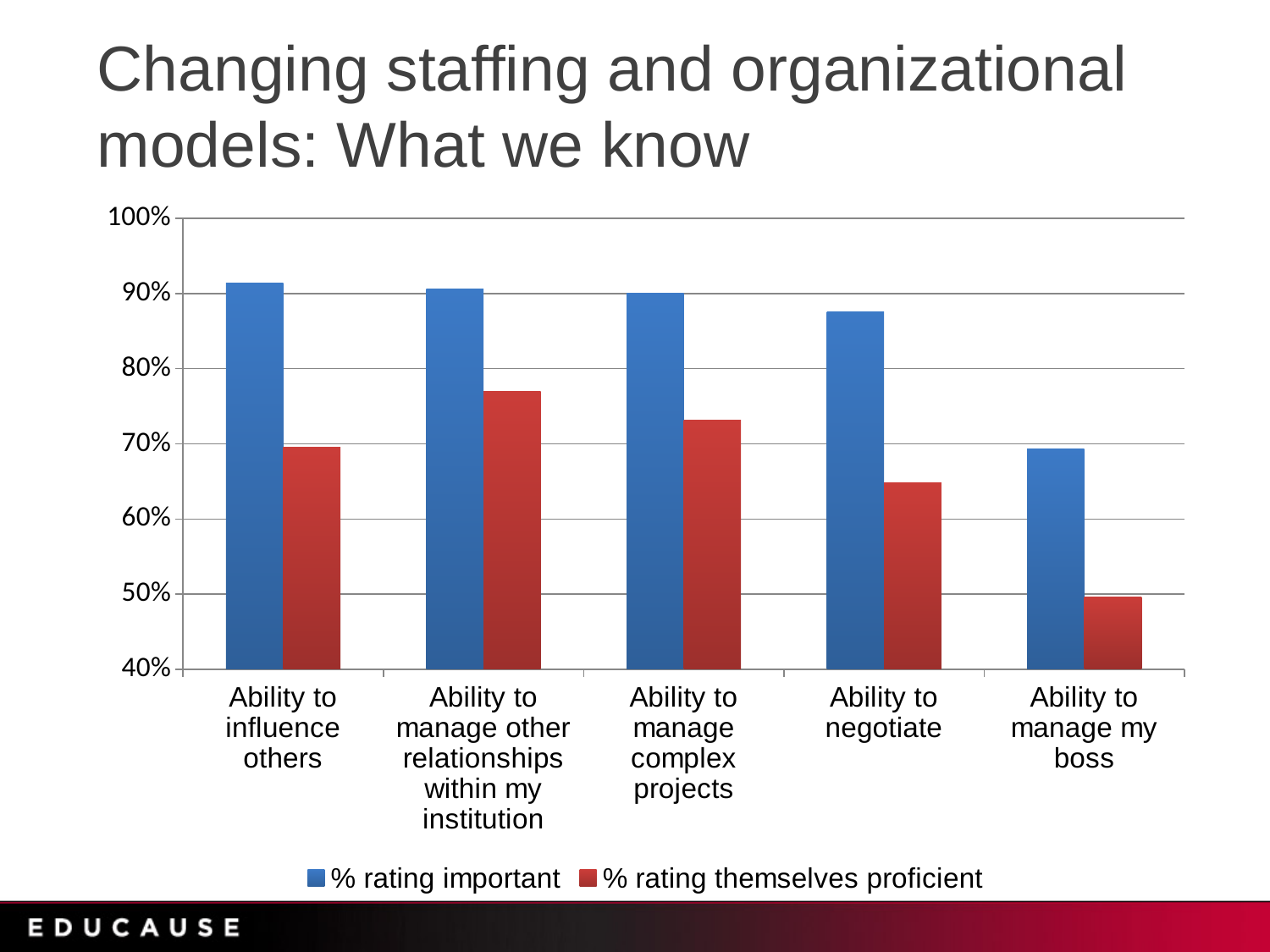
Do the "% rating important" values rise or fall moving left to right along the x axis? fall Which category has the highest value for "% rating themselves proficient"? Ability to manage other relationships within my institution What kind of chart is shown on the slide? bar chart Is the "% rating themselves proficient" value for "Ability to negotiate" greater or less than 70%? less How many series does the legend list? 2 Which is larger: the "% rating themselves proficient" value for "Ability to manage complex projects" or for "Ability to negotiate"? Ability to manage complex projects How many categories are shown on the x axis of the chart? 5 Is the "% rating important" value for "Ability to manage my boss" greater or less than 80%? less Which category has the lowest value for "% rating themselves proficient"? Ability to manage my boss Which category has the lowest value for "% rating important"? Ability to manage my boss Is the "% rating themselves proficient" value for "Ability to manage my boss" greater or less than 60%? less